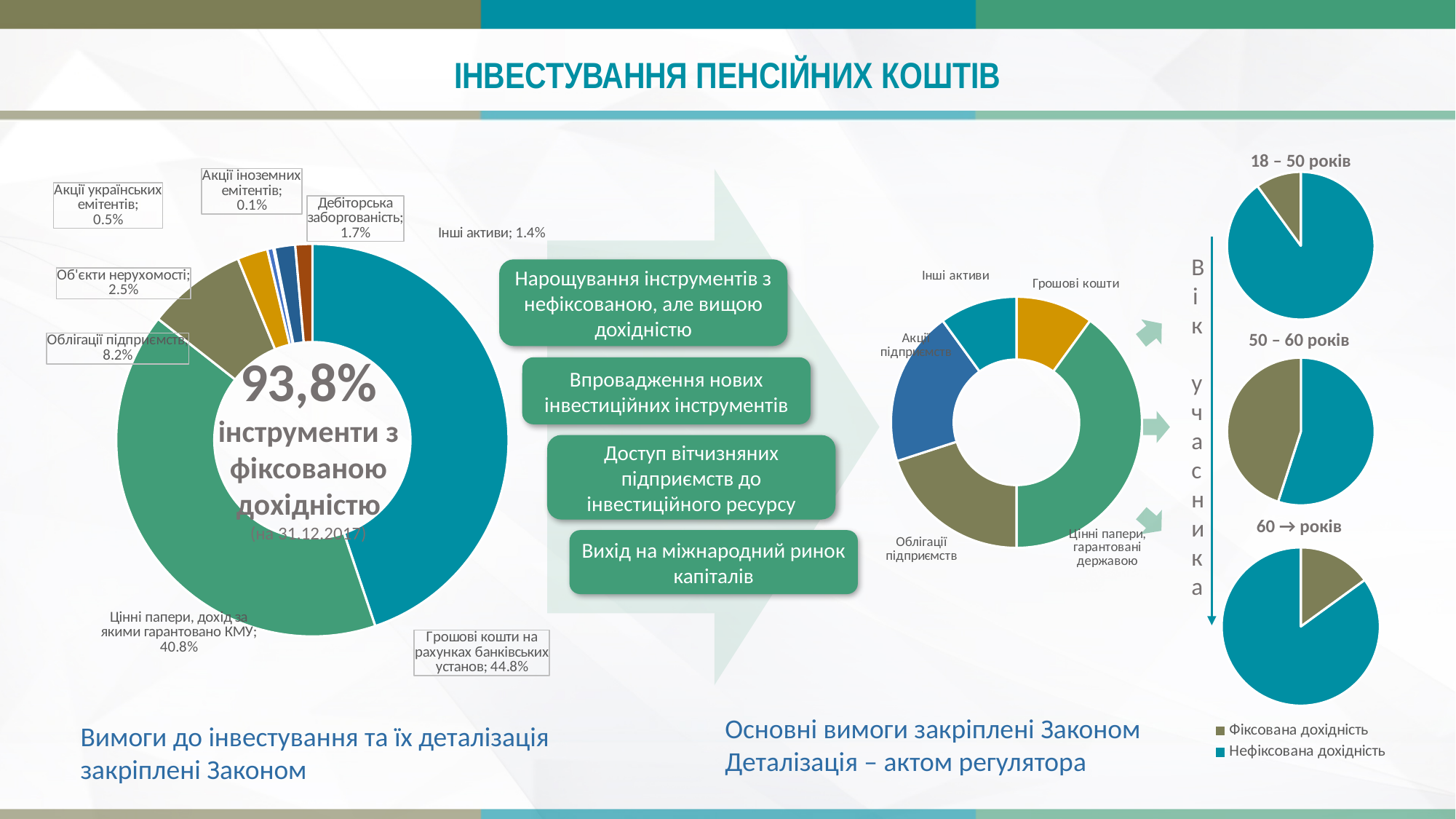
On the pie chart titled "60 → років", which is larger: "Фіксована дохідність" or "Нефіксована дохідність"? Нефіксована дохідність What percentage is printed in the centre of the large doughnut chart on the left? 93,8% On the large doughnut chart on the left, what is the value for "Грошові кошти на рахунках банківських установ"? 44.8% On the large doughnut chart on the left, which category has the largest share? Грошові кошти на рахунках банківських установ How many categories are shown on the large doughnut chart on the left? 8 On the large doughnut chart on the left, what is the value for "Цінні папери, дохід за якими гарантовано КМУ"? 40.8% On the large doughnut chart on the left, which category has the smallest share? Акції іноземних емітентів How many categories are shown on the smaller doughnut chart in the middle of the slide? 5 On the large doughnut chart on the left, what is the value for "Облігації підприємств"? 8.2% On the large doughnut chart on the left, which is larger: "Об'єкти нерухомості" or "Дебіторська заборгованість"? Об'єкти нерухомості How many series does the legend list for the three pie charts on the right? 2 On the large doughnut chart on the left, what is the difference between "Грошові кошти на рахунках банківських установ" and "Цінні папери, дохід за якими гарантовано КМУ"? 4.0%